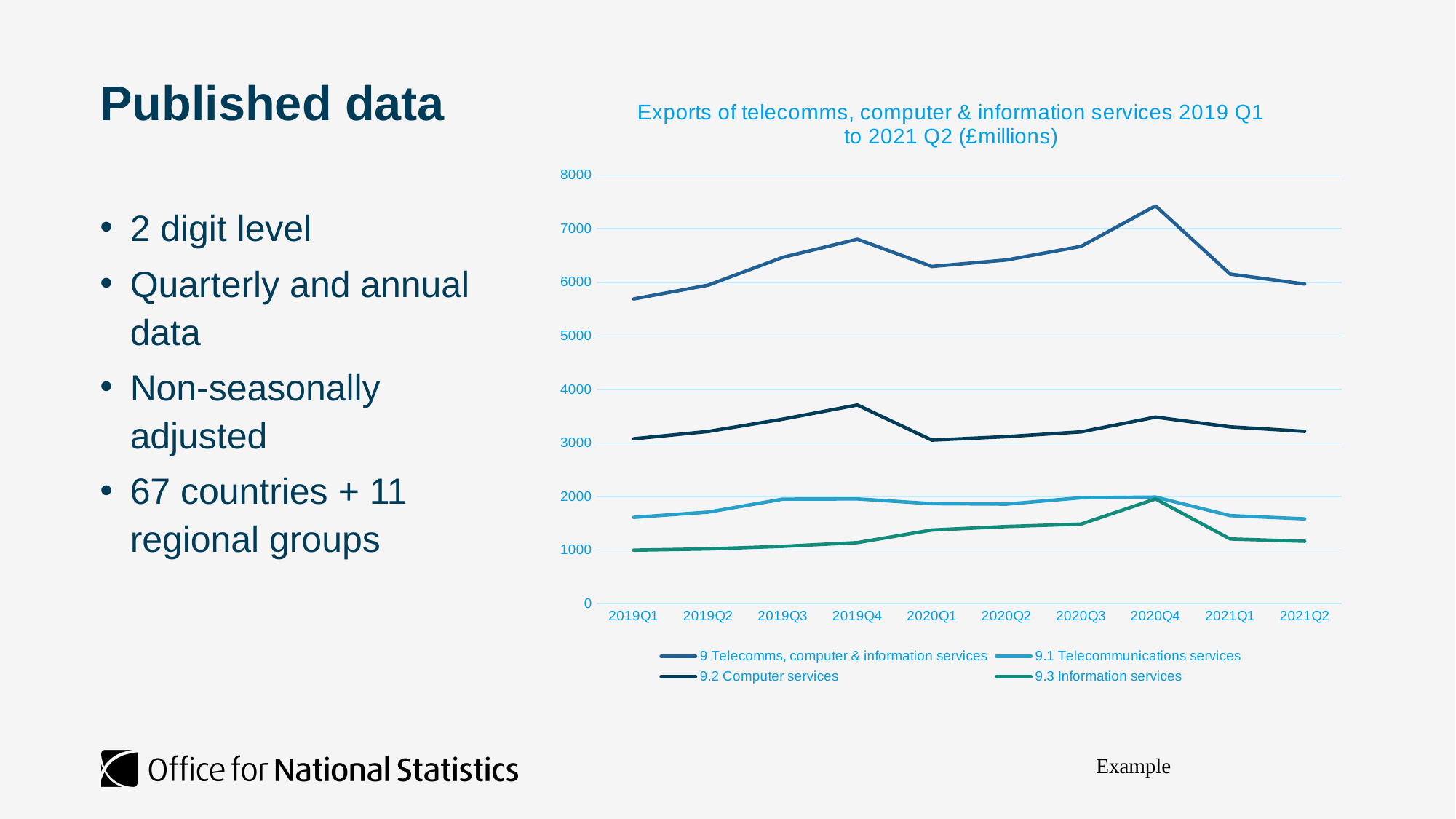
Is the value for 9.1 Telecommunications services in 2021Q2 greater or less than 2000? less In 2019Q1, which is larger: 9.1 Telecommunications services or 9.3 Information services? 9.1 Telecommunications services Which series is drawn in green? 9.3 Information services In which quarter is the 9 Telecomms, computer & information services line at its lowest? 2019Q1 Is the value for 9 Telecomms, computer & information services in 2020Q4 greater or less than 7000? greater In which quarter does the 9 Telecomms, computer & information services line reach its highest value? 2020Q4 Does the 9.3 Information services line rise or fall from 2019Q1 to 2020Q4? rise In which quarter does the 9.2 Computer services line peak? 2019Q4 How many quarters are shown along the x axis? 10 What kind of chart is shown on the slide? line chart Is the value for 9.2 Computer services in 2019Q4 greater or less than 4000? less How many series does the legend list? 4